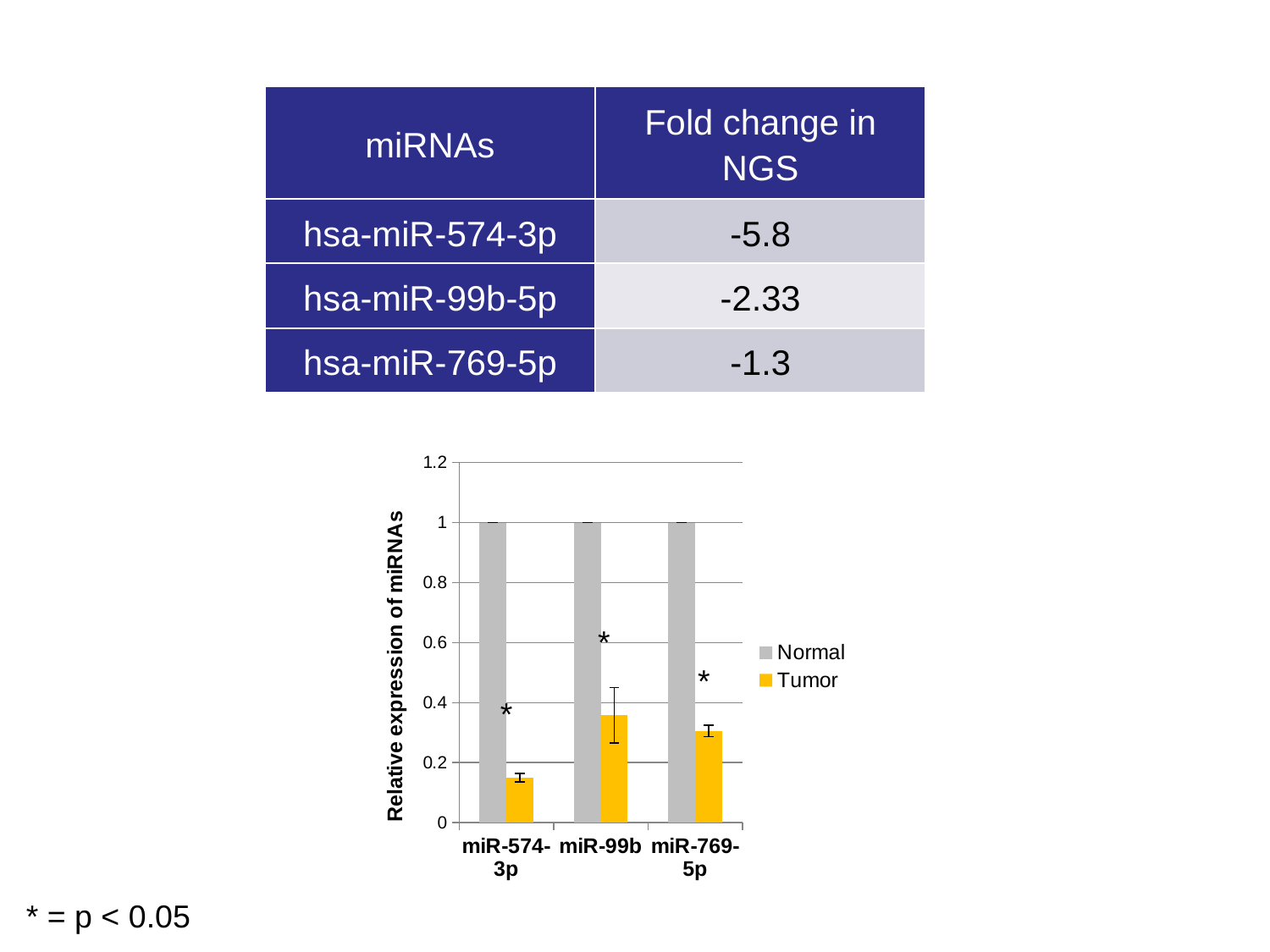
Is the Tumor value for miR-99b greater or less than 0.2? greater What is the Normal value for miR-99b in the chart? 1 Is the Tumor value for miR-574-3p greater or less than 0.2? less What kind of chart is shown on the slide? bar chart How many miRNA categories are shown on the x axis of the chart? 3 What is the y-axis title of the chart? Relative expression of miRNAs Which is larger, the Tumor value for miR-574-3p or the Tumor value for miR-99b? miR-99b Which series is shown in yellow in the chart? Tumor How many series does the chart legend list? 2 Which miRNA has the lowest Tumor value in the chart? miR-574-3p Is the Tumor value for miR-769-5p greater or less than 0.4? less What is the Normal value for miR-574-3p in the chart? 1